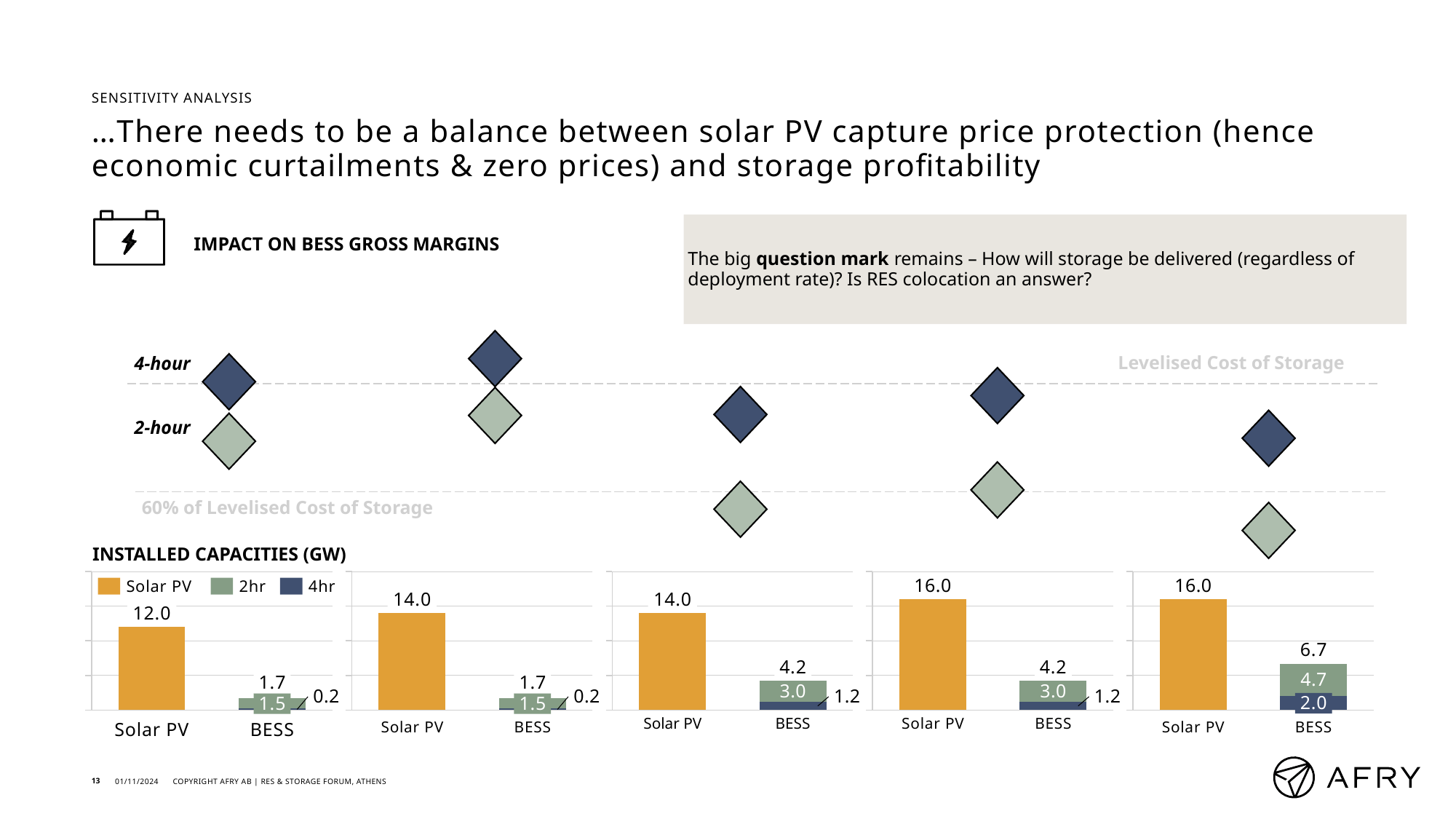
How many series does the legend of the installed capacities charts list? 3 In the second installed capacities chart from the left, what is the difference between the Solar PV value and the BESS total? 12.3 In the middle (third) installed capacities chart, what is the 2hr value for BESS? 3.0 In the rightmost installed capacities chart, what is the total of the stacked BESS bar? 6.7 In the rightmost installed capacities chart, what is the 4hr value for BESS? 2.0 What unit is given in the title of the installed capacities charts? GW In the fourth installed capacities chart from the left, which is larger, Solar PV or BESS? Solar PV In the rightmost installed capacities chart, what is the 2hr value for BESS? 4.7 Across the five installed capacities charts from left to right, does the Solar PV value rise or fall? Rise In the leftmost installed capacities chart, what is the 4hr value for BESS? 0.2 What kind of chart is used for the installed capacities? Bar chart In the leftmost installed capacities chart, what is the value for Solar PV? 12.0